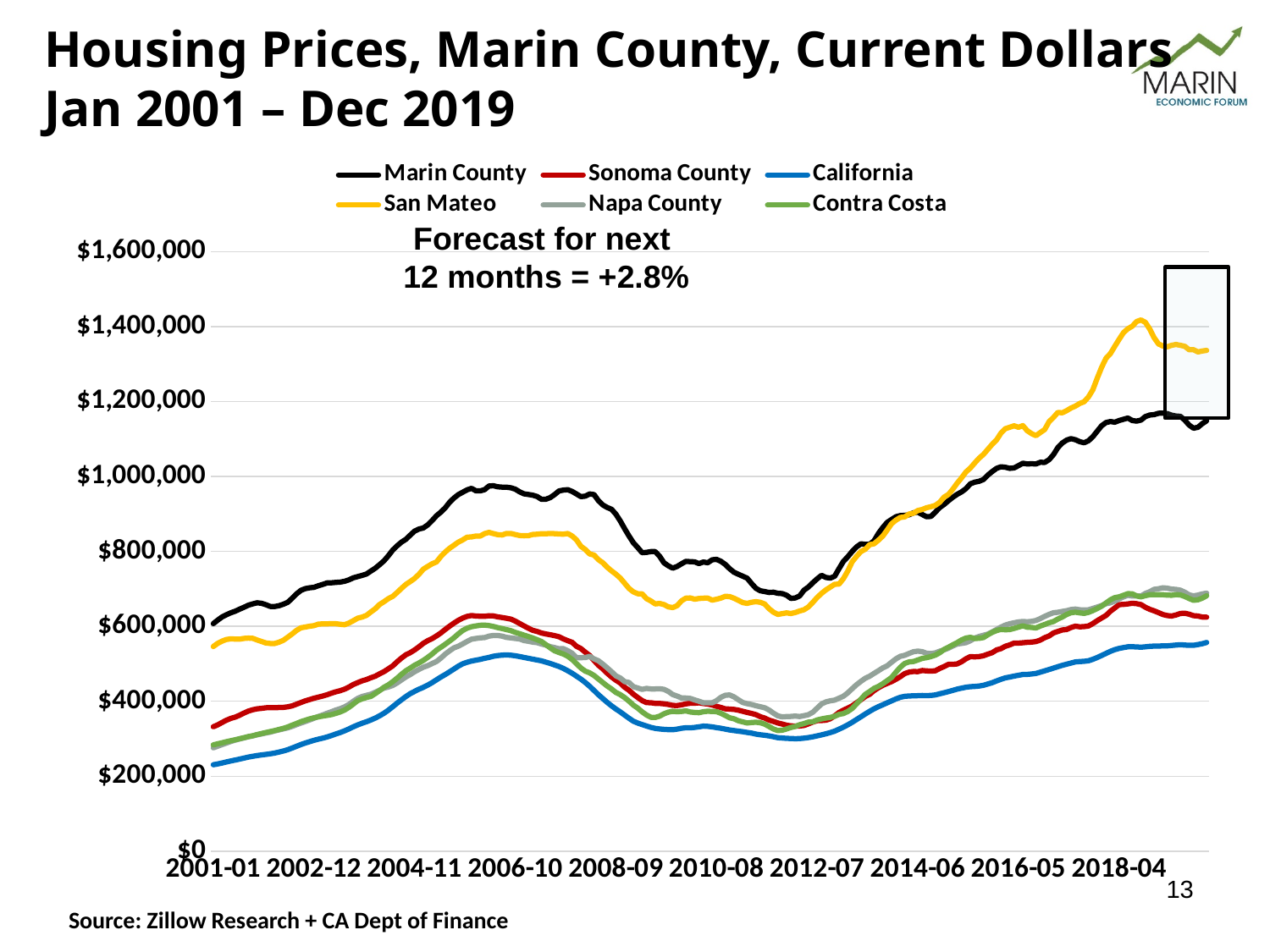
Does the Marin County line rise or fall between 2001-01 and 2006-10? rise Which series has the highest housing price at the start of the period (2001-01)? Marin County Which series has the lowest housing price at the start of the period (2001-01)? California How many series does the legend list? 6 Is the value for San Mateo at the end of the period (Dec 2019) greater or less than $1,200,000? greater Is the value for Marin County at the end of the period (Dec 2019) greater or less than $1,000,000? greater What kind of chart is shown on the slide? line chart What is the forecast for the next 12 months stated on the chart? +2.8% What is the source cited for the chart data? Zillow Research + CA Dept of Finance At the end of the period (Dec 2019), which is higher: Sonoma County or California? Sonoma County Is the value for California at 2001-01 greater or less than $400,000? less Which series has the highest housing price at the end of the period (Dec 2019)? San Mateo